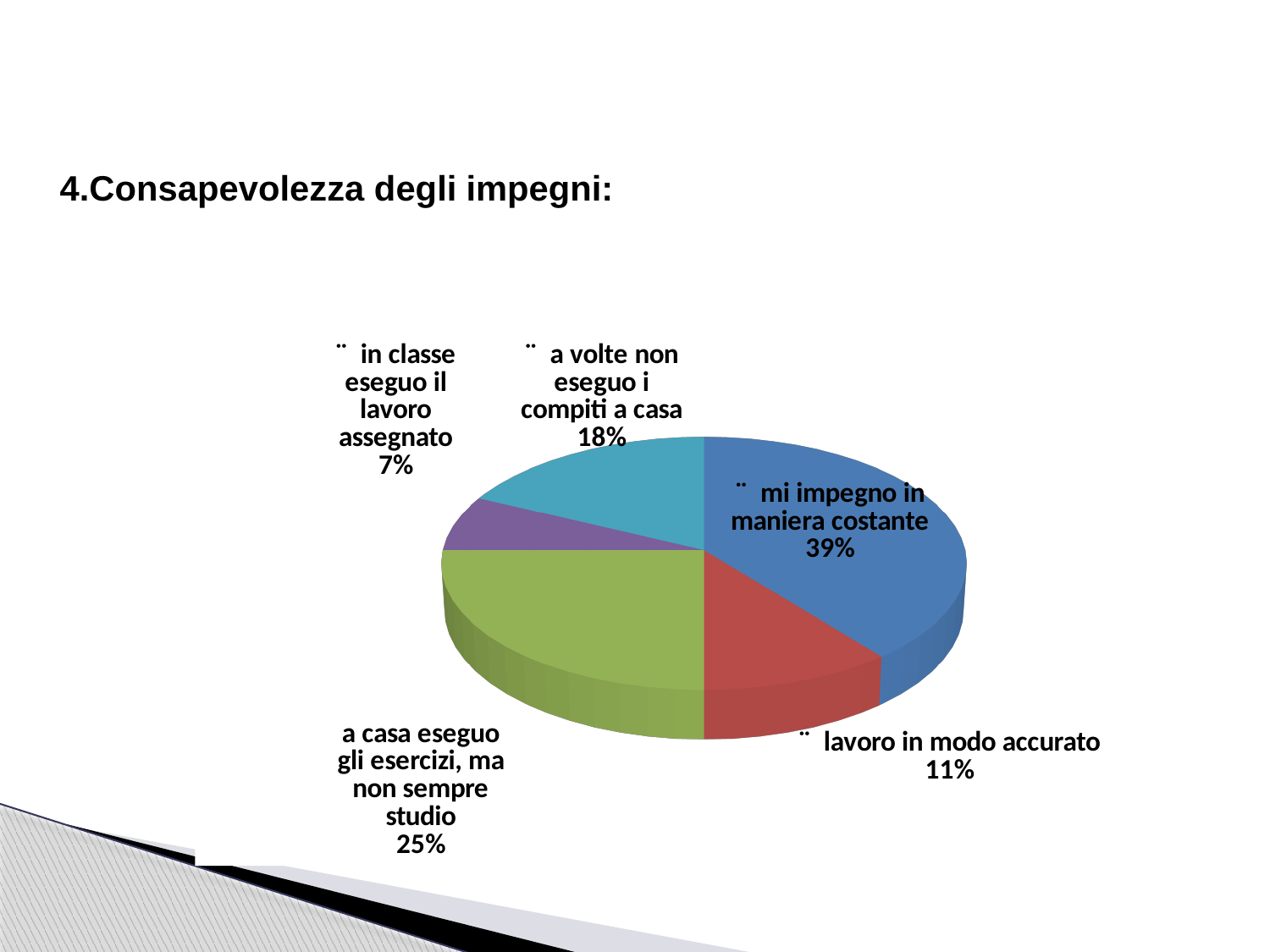
What kind of chart is shown on the slide? pie chart How many slices does the pie chart have? 5 Which slice of the pie is the largest? mi impegno in maniera costante What is the difference in percentage points between "mi impegno in maniera costante" and "a casa eseguo gli esercizi, ma non sempre studio"? 14 What percentage of the pie is labelled "in classe eseguo il lavoro assegnato"? 7% What colour is the slice for "a casa eseguo gli esercizi, ma non sempre studio"? green Which slice of the pie is the smallest? in classe eseguo il lavoro assegnato What percentage of the pie is labelled "a volte non eseguo i compiti a casa"? 18% Which is larger: the slice for "a volte non eseguo i compiti a casa" or the slice for "lavoro in modo accurato"? a volte non eseguo i compiti a casa What percentage of the pie is labelled "lavoro in modo accurato"? 11% What percentage of the pie is labelled "mi impegno in maniera costante"? 39% What percentage of the pie is labelled "a casa eseguo gli esercizi, ma non sempre studio"? 25%